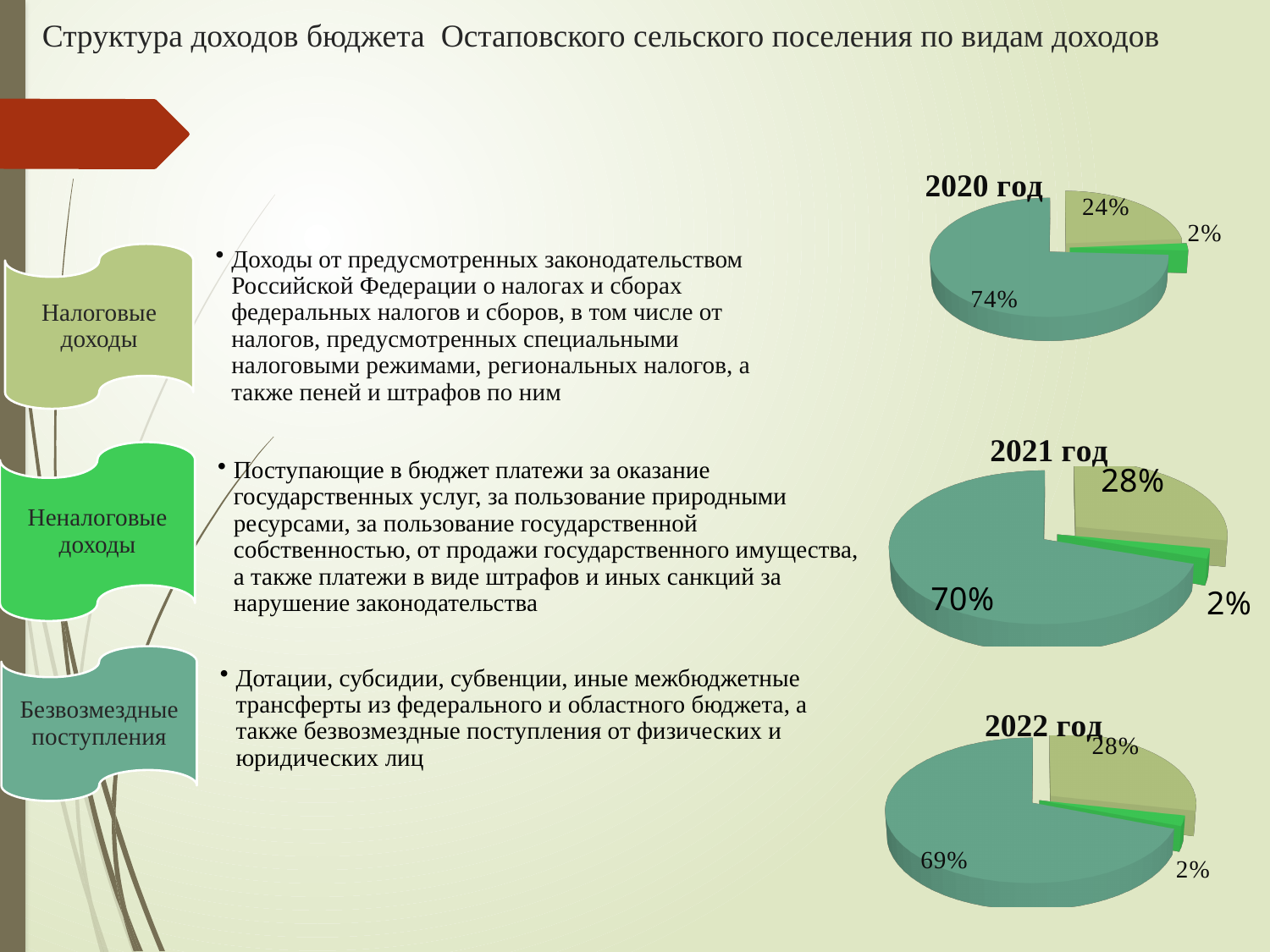
In the "2022 год" chart, what is the value of the light green slice? 28% How many pie charts are shown on the slide? 3 Which chart has the larger largest slice, "2020 год" or "2021 год"? 2020 год In the "2020 год" chart, what is the difference between the largest slice (74%) and the second largest slice (24%)? 50% What kind of chart is the "2020 год" chart? Pie chart In the "2020 год" chart, what is the value of the largest slice? 74% Does the value of the largest slice rise or fall from the 2020 chart to the 2022 chart? Fall In the "2020 год" chart, what is the value of the smallest slice? 2% How many slices does the "2021 год" pie chart have? 3 In the "2022 год" chart, what is the value of the largest slice? 69% In the "2021 год" chart, what is the difference between the 70% slice and the 28% slice? 42% In the "2021 год" chart, what is the value of the largest slice? 70%